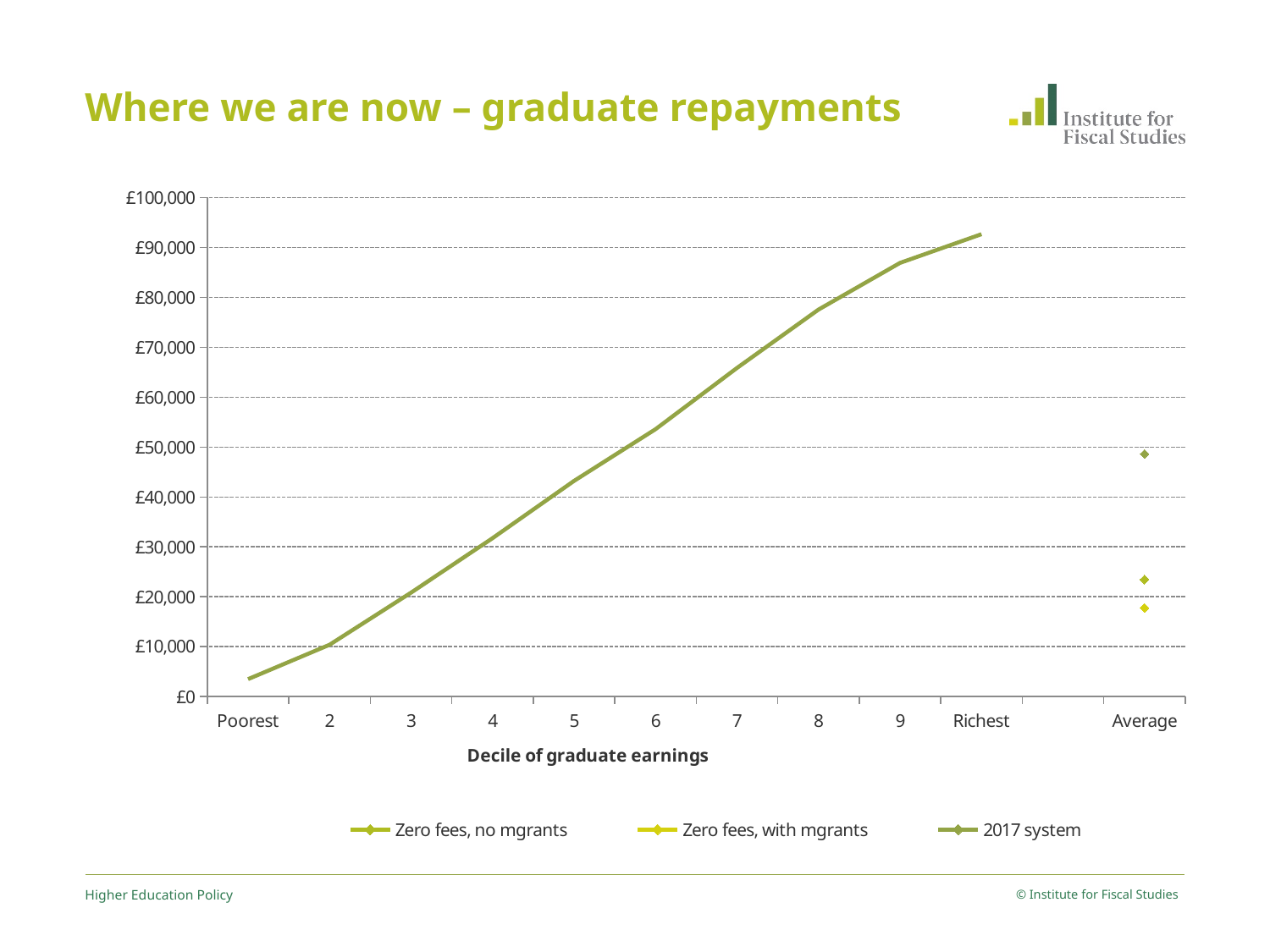
How many categories are shown on the x axis? 11 At Average, which is larger: the 2017 system or Zero fees, with mgrants? 2017 system How many series does the legend list? 3 Is the Average value for Zero fees, with mgrants greater or less than £20,000? less What is the title of the x axis? Decile of graduate earnings What kind of chart is shown on the slide? line chart